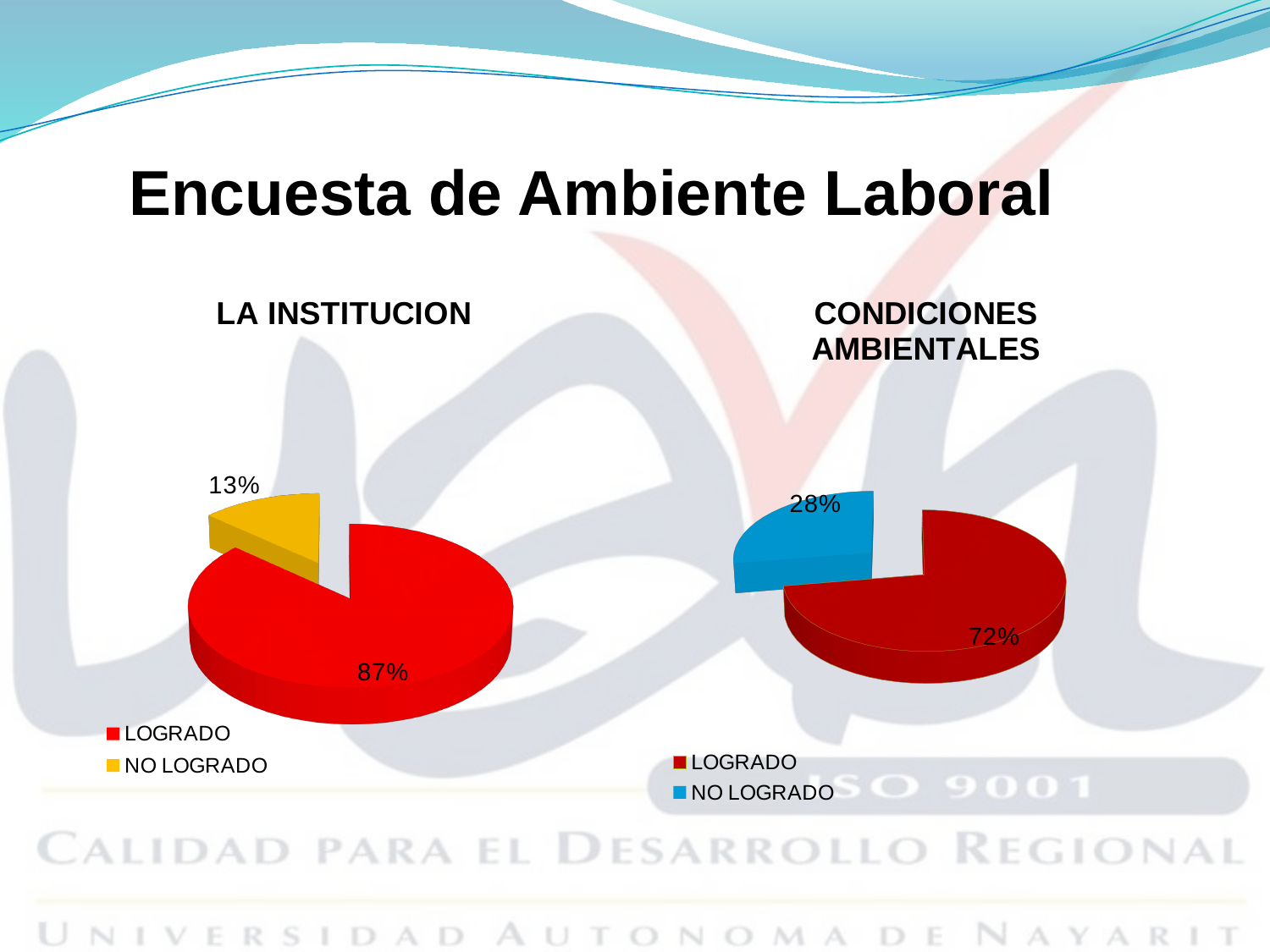
In the LA INSTITUCION chart, what percentage is NO LOGRADO? 13% In the CONDICIONES AMBIENTALES chart, what percentage is NO LOGRADO? 28% In the LA INSTITUCION chart, what percentage is LOGRADO? 87% In the LA INSTITUCION chart, which slice is the largest? LOGRADO What type of chart is the LA INSTITUCION chart? Pie chart How many entries does the legend of the LA INSTITUCION chart list? 2 In the CONDICIONES AMBIENTALES chart, what colour is the NO LOGRADO slice? Blue Is the LOGRADO share larger in the LA INSTITUCION chart or in the CONDICIONES AMBIENTALES chart? LA INSTITUCION In the LA INSTITUCION chart, what is the difference between LOGRADO and NO LOGRADO? 74% How many slices does the CONDICIONES AMBIENTALES chart have? 2 In the CONDICIONES AMBIENTALES chart, what percentage is LOGRADO? 72% In the CONDICIONES AMBIENTALES chart, which slice is the smallest? NO LOGRADO